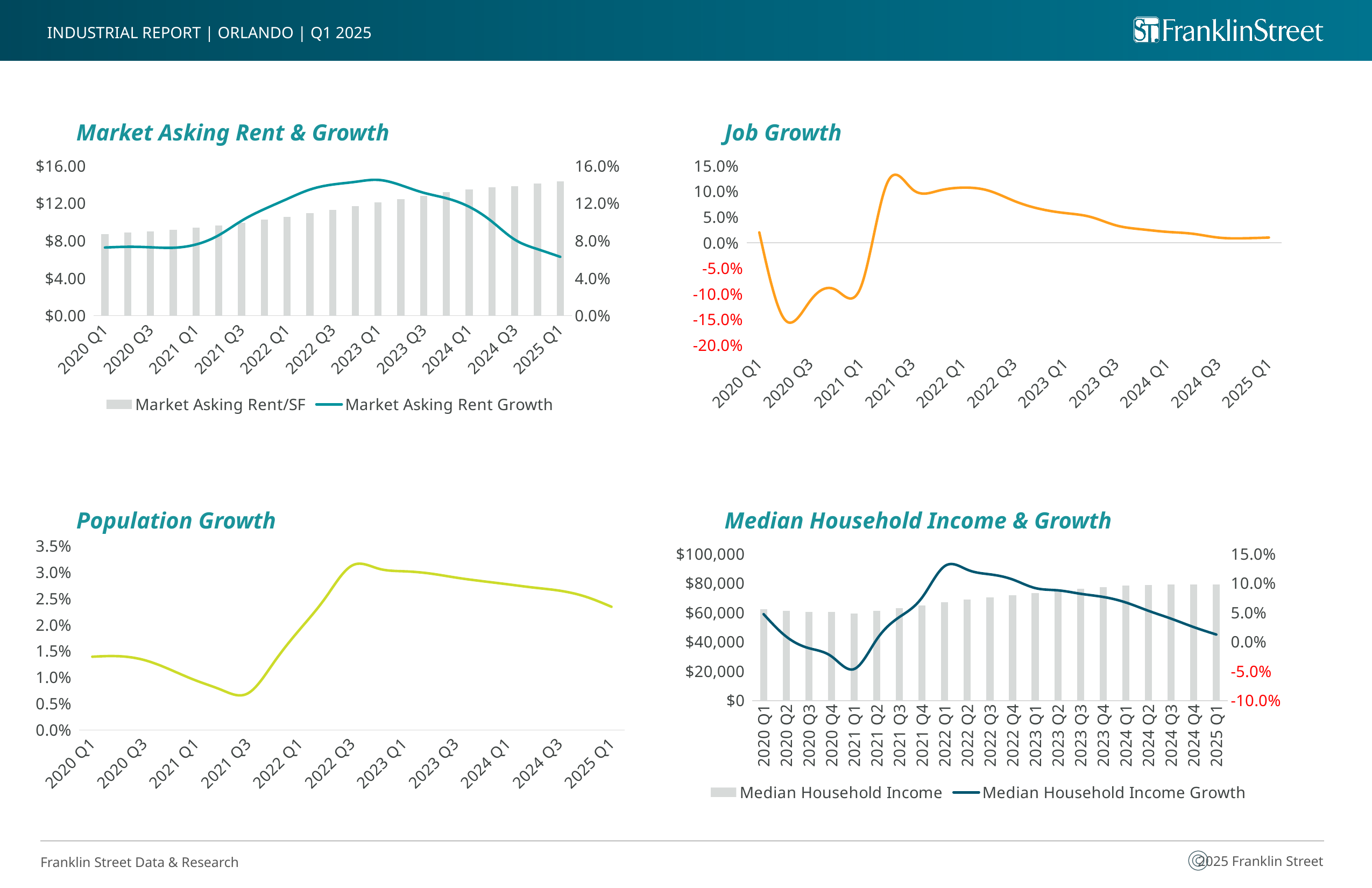
In the Population Growth chart, which quarter has the lowest population growth? 2021 Q3 In the Market Asking Rent & Growth chart, is the Market Asking Rent Growth for 2025 Q1 greater or less than 8.0%? less In the Market Asking Rent & Growth chart, is the Market Asking Rent/SF for 2025 Q1 greater or less than $12.00? greater What kind of chart is the Market Asking Rent & Growth chart? Combined bar and line chart In the Market Asking Rent & Growth chart, do the Market Asking Rent/SF bars rise or fall from 2020 Q1 to 2025 Q1? rise In the Median Household Income & Growth chart, how many quarters are shown on the x axis? 21 In the Median Household Income & Growth chart, is the Median Household Income for 2025 Q1 greater or less than $60,000? greater In the Job Growth chart, which quarter has the lowest job growth? 2020 Q2 How many series does the legend of the Market Asking Rent & Growth chart list? 2